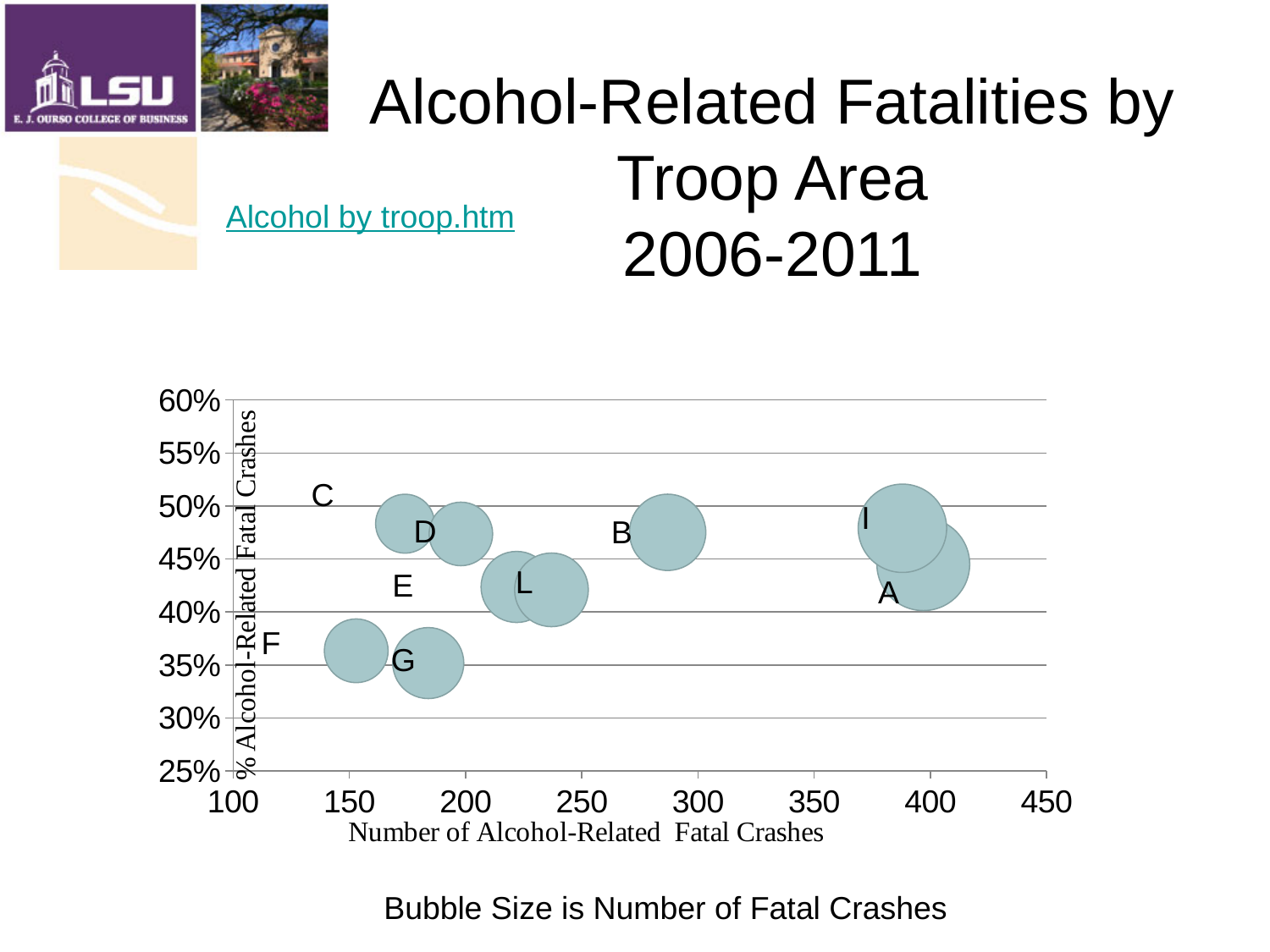
Is the percentage of alcohol-related fatal crashes for troop G greater or less than 40%? less Which troop has more alcohol-related fatal crashes, B or F? B Which troop has more alcohol-related fatal crashes, A or G? A What is the title of the x axis? Number of Alcohol-Related Fatal Crashes According to the slide, what does the bubble size represent? Number of Fatal Crashes Is the number of alcohol-related fatal crashes for troop I greater or less than 350? greater Is the number of alcohol-related fatal crashes for troop F greater or less than 200? less Which troop has a higher percentage of alcohol-related fatal crashes, B or G? B What kind of chart is shown on the slide? Bubble chart How many bubbles are plotted on the chart? 9